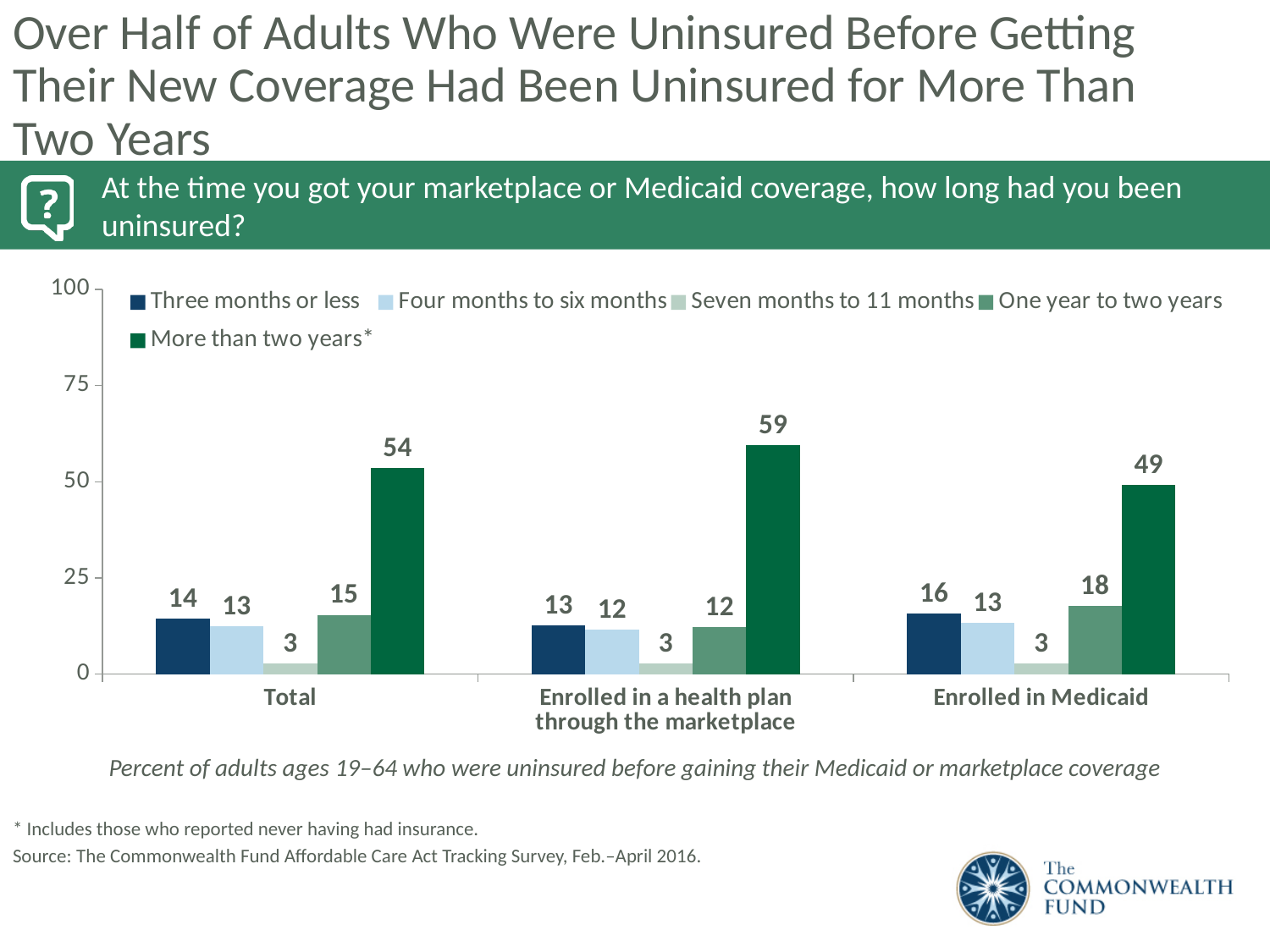
Is the value for "More than two years*" in the Total category greater or less than 50? greater What kind of chart is shown on the slide? Bar chart What is the maximum value shown on the y axis? 100 What is the difference between the "More than two years*" values for the marketplace and Medicaid categories? 10 Which category has the highest value for "More than two years*"? Enrolled in a health plan through the marketplace Which is larger: "Three months or less" for Enrolled in Medicaid or "Three months or less" for Total? Enrolled in Medicaid How many series does the legend list? 5 What is the value for "More than two years*" in the Total category? 54 Which series has the lowest value in the Enrolled in Medicaid category? Seven months to 11 months What is the value for "Three months or less" for adults enrolled in a health plan through the marketplace? 13 How many categories are shown on the x axis? 3 What is the value for "One year to two years" for adults enrolled in Medicaid? 18